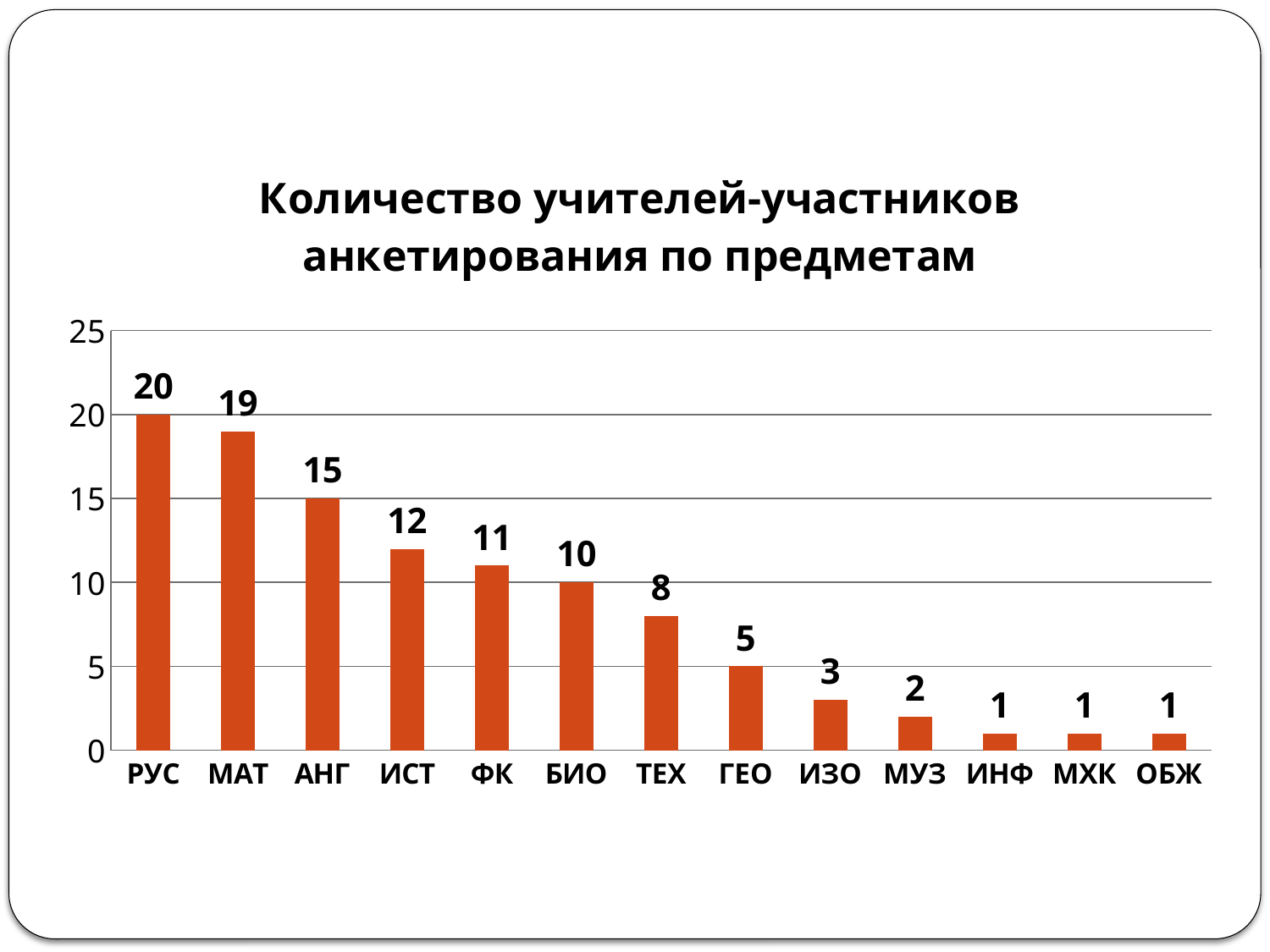
What kind of chart is this? bar chart Is the value for БИО greater or less than 5? greater What is the difference between the values for МАТ and АНГ? 4 How many categories have a value of 1? 3 What is the value for ГЕО? 5 How many categories are shown on the x axis? 13 What is the value for ИСТ? 12 What is the title of the chart? Количество учителей-участников анкетирования по предметам Which category has the highest value? РУС What is the value for РУС? 20 Do the values rise or fall from left to right along the x axis? fall Which is larger, the value for ФК or the value for ТЕХ? ФК